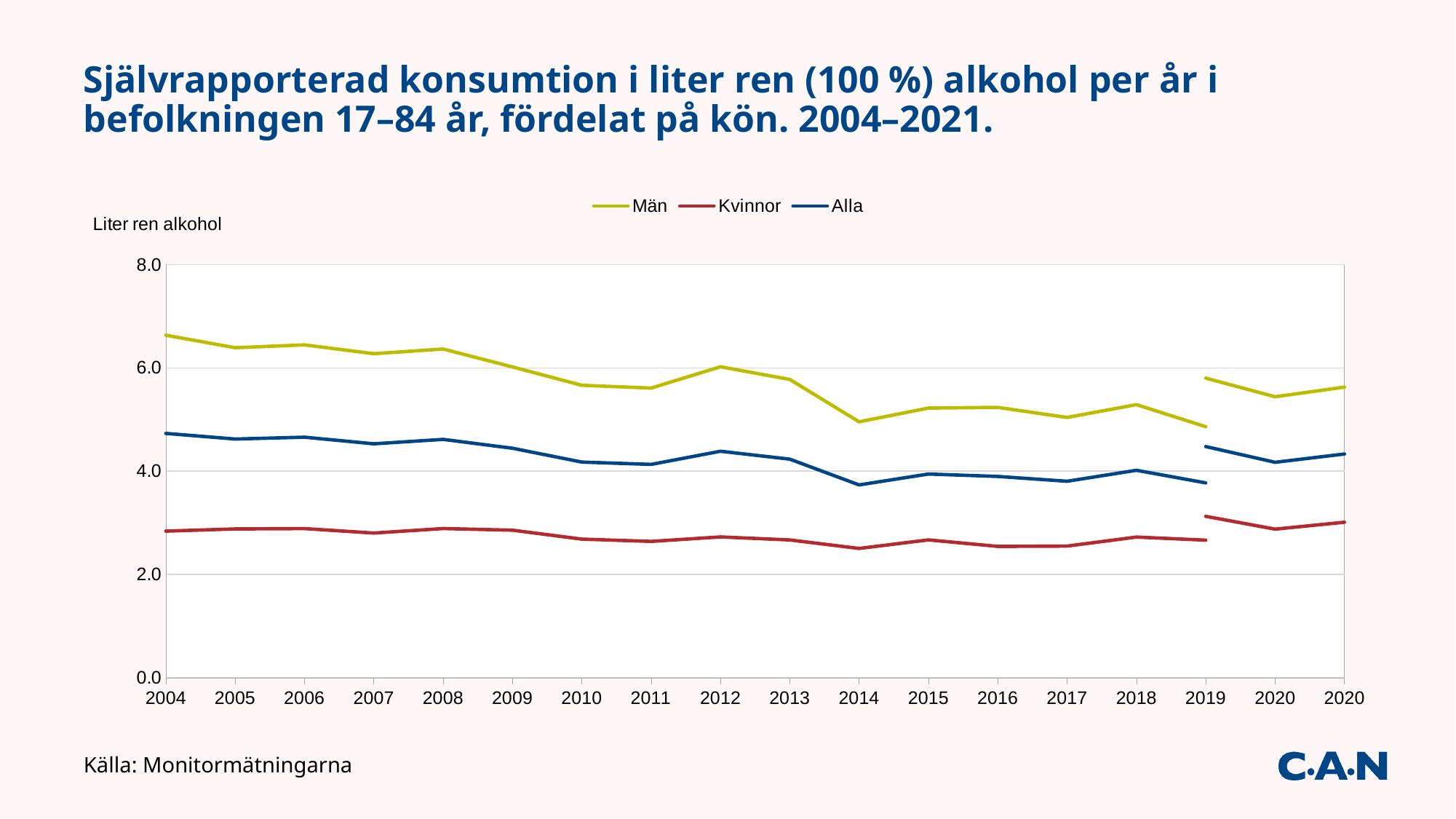
Is the value for Alla in 2014 greater or less than 4.0? less Is the value for Män in 2004 greater or less than 6.0? greater Is the value for Alla in 2004 greater or less than 4.0? greater What is the label on the y axis? Liter ren alkohol Does the Män series generally rise or fall from 2004 to 2019? Fall What kind of chart is shown on the slide? Line chart Which series has the highest values across the chart? Män How many series does the legend list? 3 Which series are listed in the legend? Män, Kvinnor, Alla Which series has the lowest values across the chart? Kvinnor